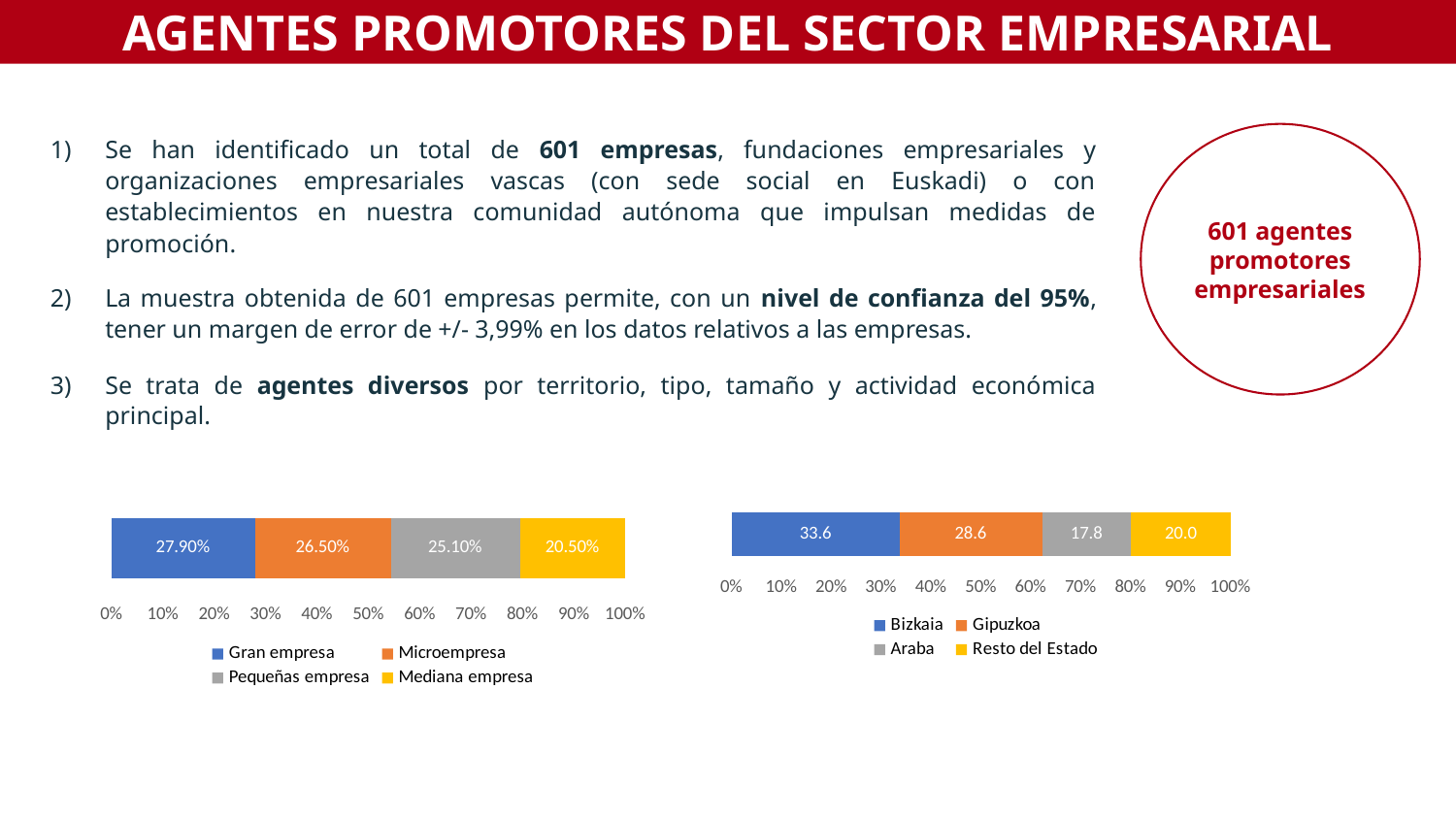
In the right chart, what is the difference between Bizkaia and Gipuzkoa? 5.0 In the left chart, which segment has the highest value? Gran empresa What kind of chart is the right chart? Stacked bar chart In the right chart, which is larger, Gipuzkoa or Resto del Estado? Gipuzkoa In the left chart, what is the difference between Microempresa and Pequeñas empresa? 1.40% In the right chart, what is the value for Bizkaia? 33.6 In the right chart, what is the value for Araba? 17.8 In the left chart, which segment has the lowest value? Mediana empresa In the left chart, what is the value for Gran empresa? 27.90% In the left chart, what is the value for Mediana empresa? 20.50% In the right chart, which segment has the lowest value? Araba In the left chart, how many series does the legend list? 4